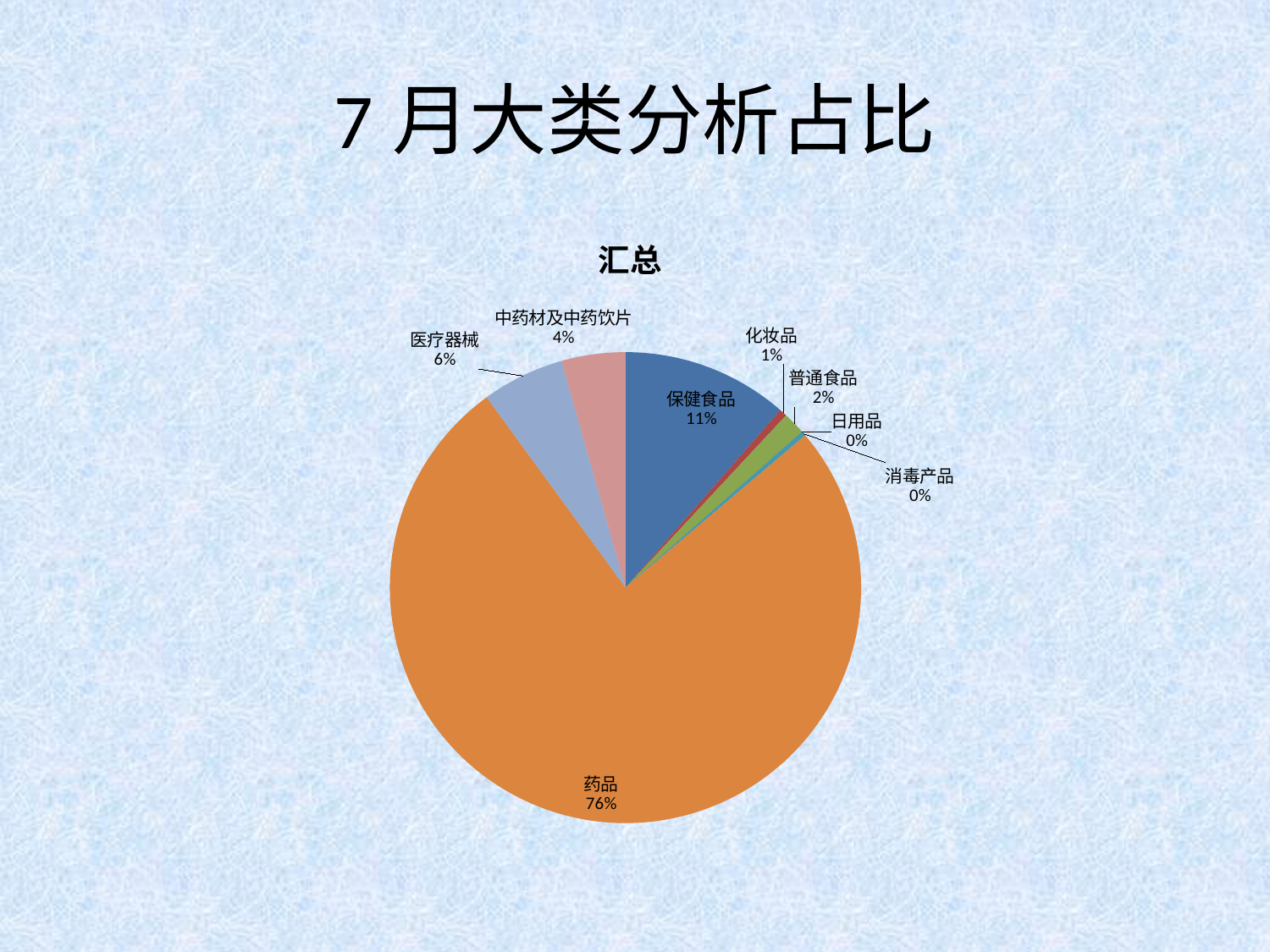
Which category has the largest slice? 药品 Which is larger, the share of 医疗器械 or the share of 中药材及中药饮片? 医疗器械 How many categories are shown in the pie chart? 8 What is the value shown for 中药材及中药饮片? 4% What is the value shown for 化妆品? 1% What share of the pie does 保健食品 take? 11% What is the value shown for 普通食品? 2% What is the value shown for 医疗器械? 6% What is the chart's title? 汇总 What kind of chart is shown on the slide? pie chart What share of the pie does 药品 take? 76% What is the difference between the shares of 药品 and 保健食品? 65%